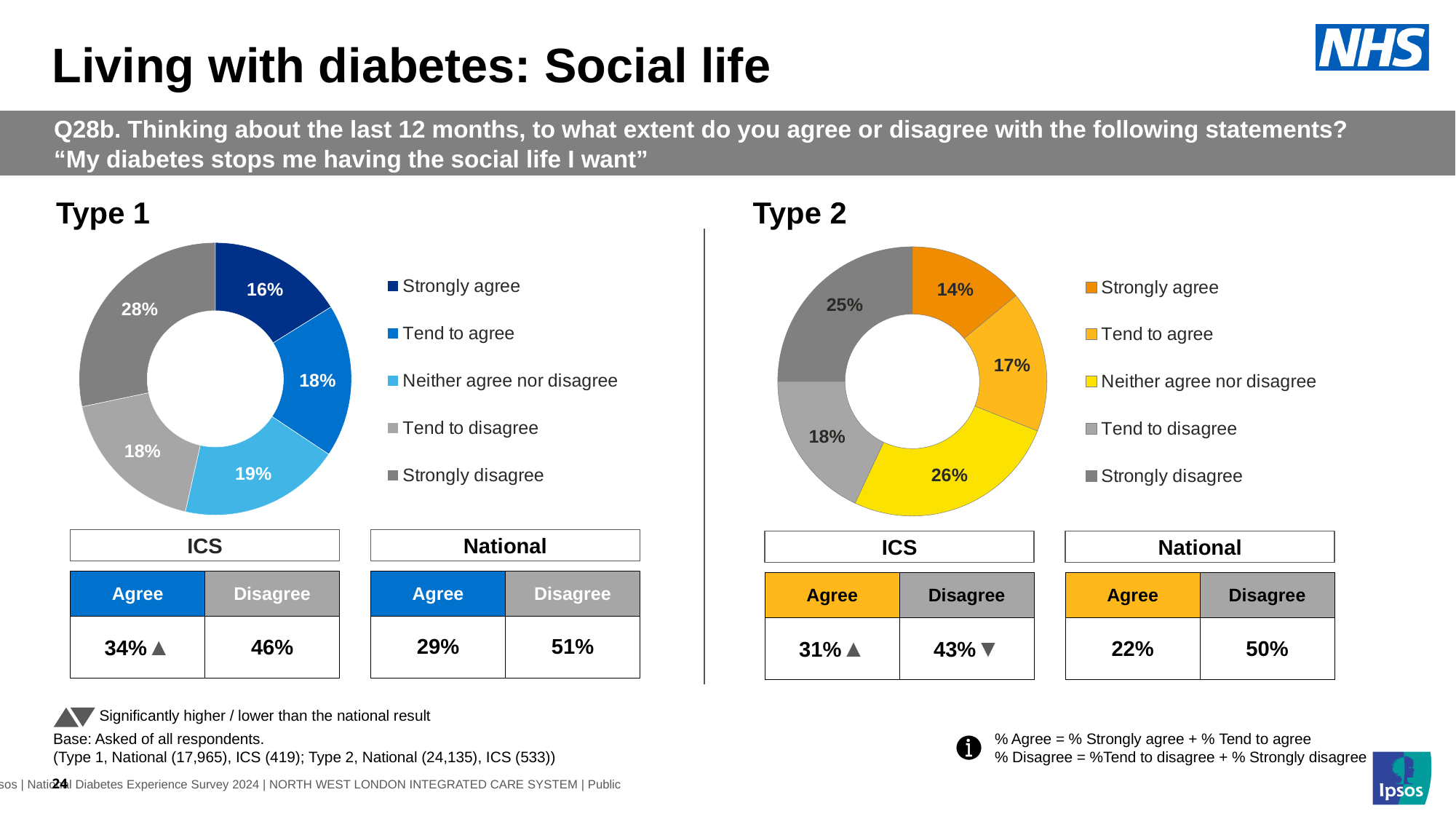
In the Type 2 chart, which category has the smallest share? Strongly agree In the Type 2 chart, what percentage is shown for Tend to agree? 17% In the Type 1 chart, what percentage is shown for Strongly agree? 16% In the Type 1 chart, what is the difference between the Strongly disagree and Strongly agree percentages? 12% In the Type 1 chart, which category has the largest share? Strongly disagree In the Type 1 chart, what percentage is shown for Strongly disagree? 28% What kind of chart is used for Type 2? Donut (pie) chart In the Type 2 chart, what percentage is shown for Neither agree nor disagree? 26% How many categories does the Type 1 chart show? 5 In the Type 2 chart, which is larger: Neither agree nor disagree or Strongly disagree? Neither agree nor disagree In the Type 2 chart, what is the difference between the Strongly disagree and Tend to disagree percentages? 7% In the Type 1 chart, what colour represents Strongly agree? Dark blue